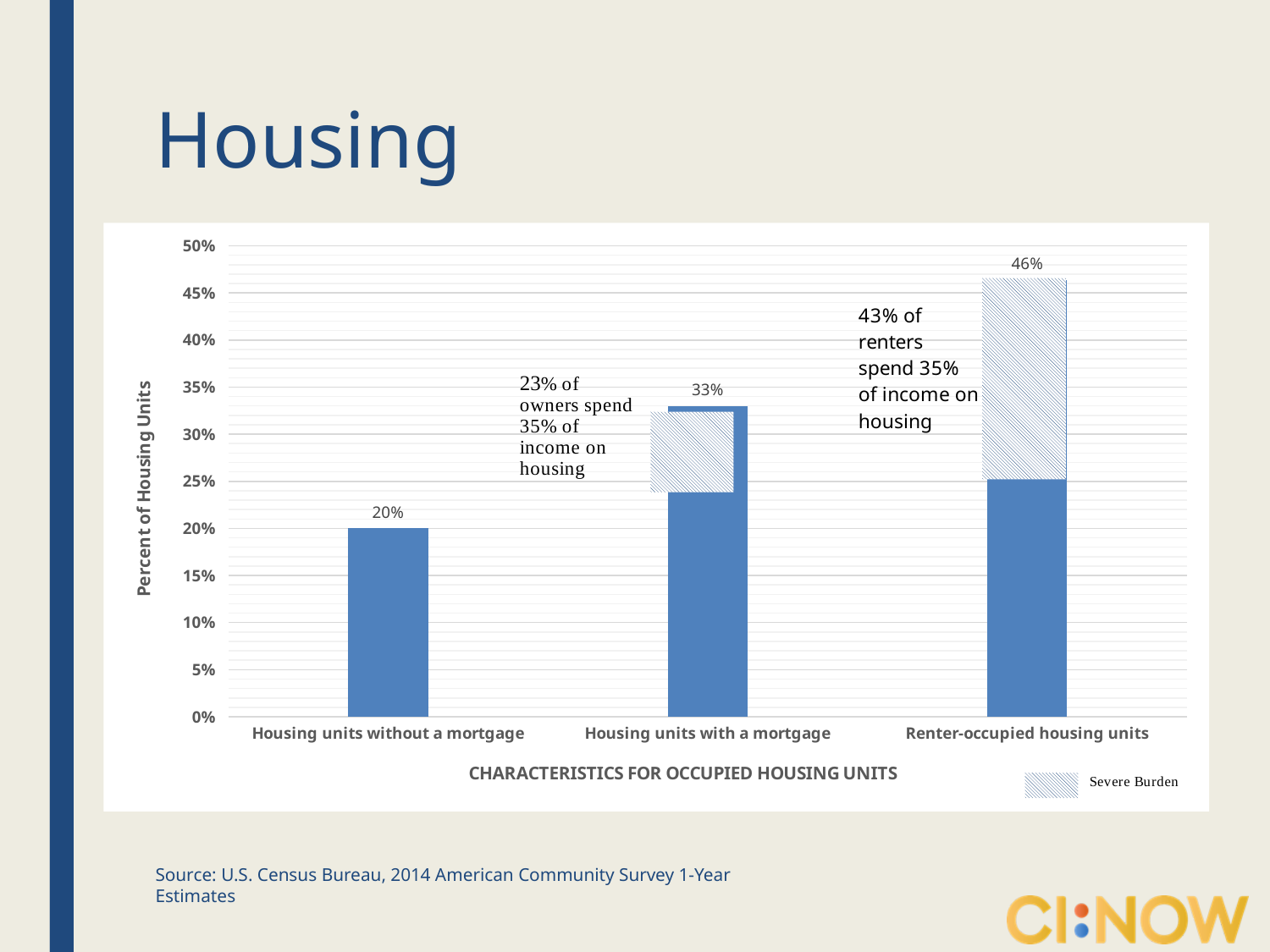
Which category has the highest value? Renter-occupied housing units What is the difference between the values for Housing units with a mortgage and Housing units without a mortgage? 13 percentage points What kind of chart is shown on the slide? Bar chart How many categories are shown on the x axis? 3 What is the value for Housing units without a mortgage? 20% What is the label on the y axis of the chart? Percent of Housing Units What is the value for Housing units with a mortgage? 33% Do the values rise or fall from left to right along the x axis? Rise What is the value for Renter-occupied housing units? 46% Which is larger, the value for Housing units with a mortgage or the value for Housing units without a mortgage? Housing units with a mortgage What is the difference between the values for Renter-occupied housing units and Housing units without a mortgage? 26 percentage points Which category has the lowest value? Housing units without a mortgage